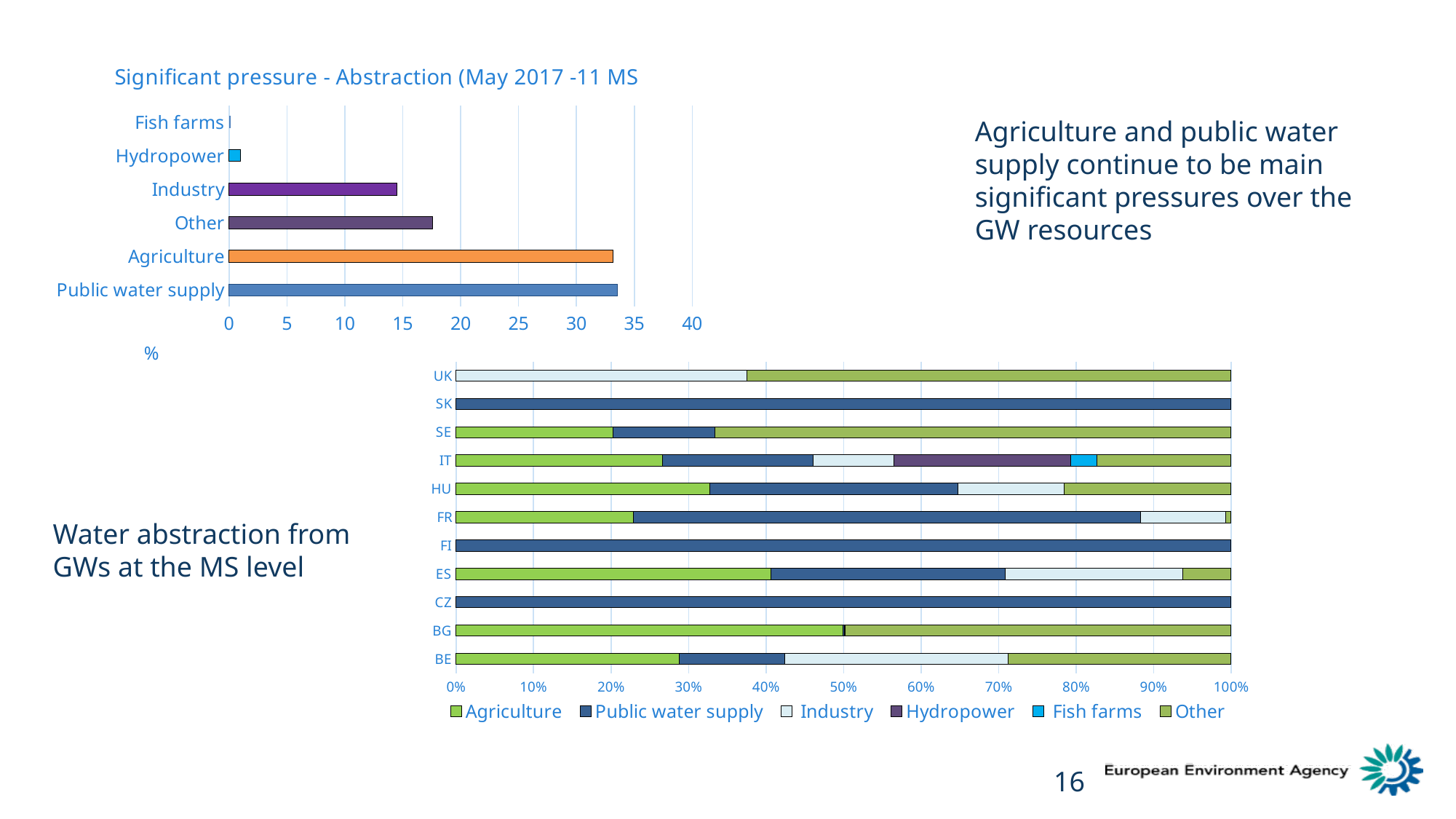
In the 'Significant pressure - Abstraction' chart, is the value for Industry greater or less than 15? less In the bottom stacked bar chart, is the Agriculture share for HU greater or less than 30%? greater In the bottom stacked bar chart, is the Industry share for UK greater or less than 40%? less How many categories are shown in the 'Significant pressure - Abstraction' chart? 6 In the 'Significant pressure - Abstraction' chart, which is larger: Industry or Other? Other In the 'Significant pressure - Abstraction' chart, which category has the lowest value? Fish farms What kind of chart is the 'Significant pressure - Abstraction' chart at the top left? bar chart How many countries are shown in the bottom stacked bar chart? 11 How many series does the legend of the bottom stacked bar chart list? 6 In the bottom stacked bar chart, which countries have bars made up entirely of Public water supply? SK, FI, CZ